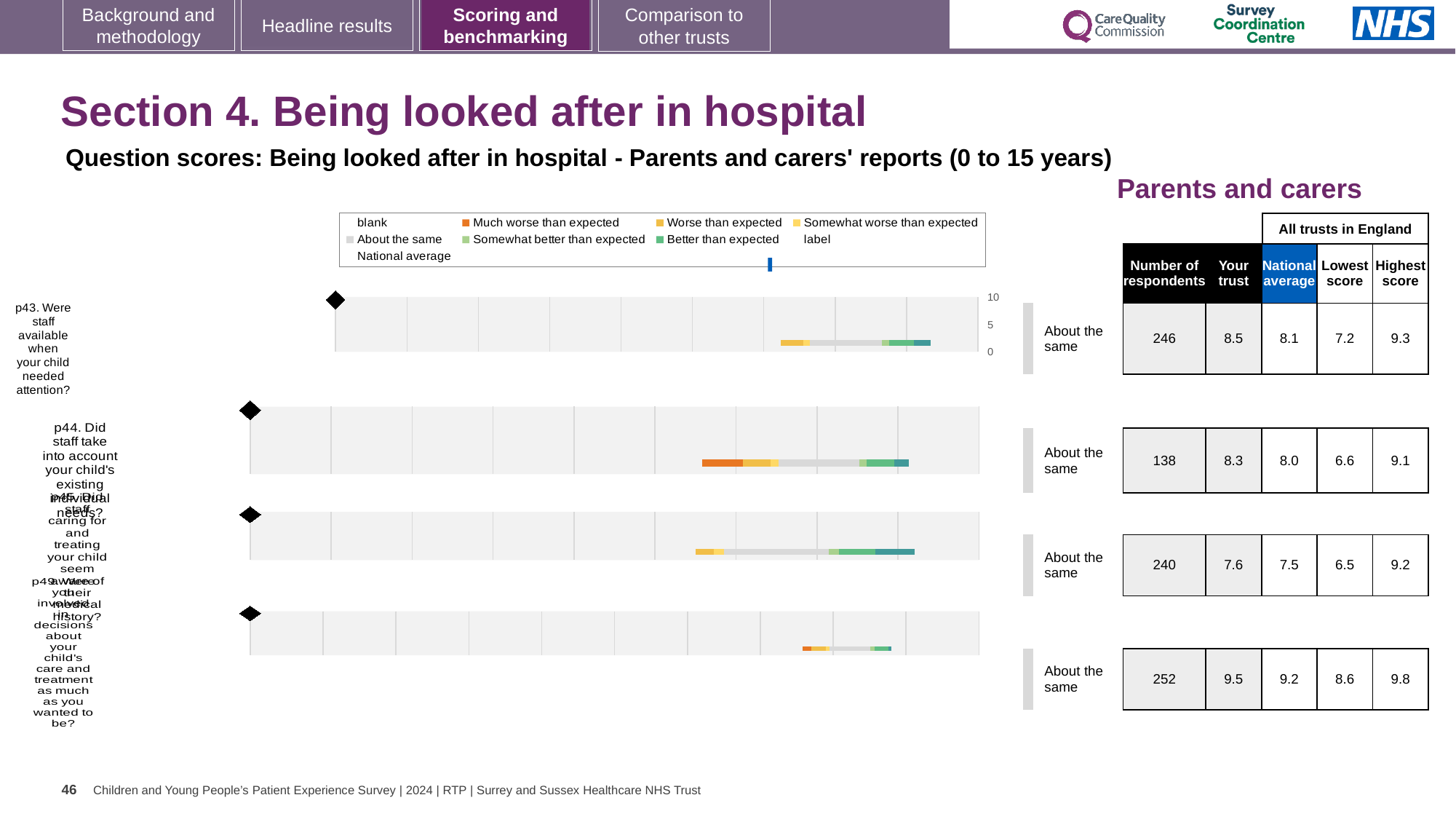
Which of the four question rows has the highest 'Your trust' score? the bottom row (p49), 9.5 For p43 'Were staff available when your child needed attention?', what is the 'Your trust' score? 8.5 For p43 'Were staff available when your child needed attention?', what is the national average score? 8.1 For p44 'Did staff take into account your child's existing individual needs?', how many respondents are there? 138 Which of the four question rows has the lowest 'Your trust' score? the third row (p45), 7.6 What is the highest tick value shown on the axis of the top chart (p43)? 10 What is the highest score among all trusts in England for p43? 9.3 For p44, which is larger: the 'Your trust' score or the national average? Your trust How many question charts (rows) are shown on the slide? 4 What colour does the legend use for 'Much worse than expected'? orange For p43, what is the difference between the 'Your trust' score and the national average? 0.4 What kind of chart is used to show the question scores on this slide? bar chart